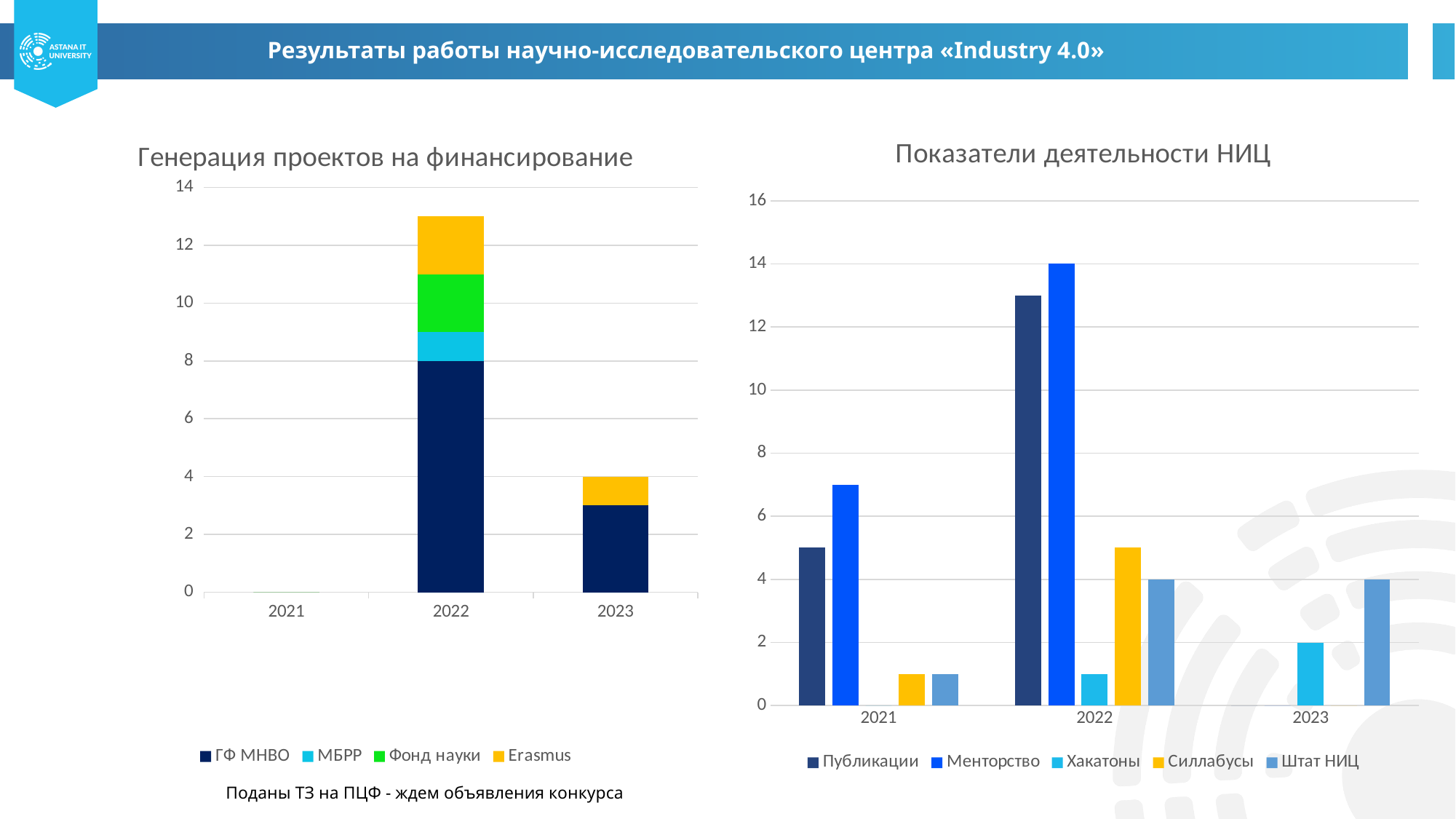
In the right chart, "Показатели деятельности НИЦ", what is the value of Хакатоны for 2023? 2 In the right chart, "Показатели деятельности НИЦ", what is the value of Менторство for 2022? 14 In the left chart, "Генерация проектов на финансирование", which year has the tallest stacked bar? 2022 In the right chart, "Показатели деятельности НИЦ", which series has the highest value in 2022? Менторство How many series does the legend of the right chart, "Показатели деятельности НИЦ", list? 5 In the right chart, "Показатели деятельности НИЦ", which is larger: Публикации in 2021 or Менторство in 2021? Менторство in 2021 In the left chart, "Генерация проектов на финансирование", is the total for 2022 greater or less than 12? greater How many series does the legend of the left chart, "Генерация проектов на финансирование", list? 4 In the right chart, "Показатели деятельности НИЦ", is the value of Публикации for 2022 greater or less than 12? greater How many year categories are shown on the x axis of the right chart, "Показатели деятельности НИЦ"? 3 What kind of chart is the left chart, "Генерация проектов на финансирование"? Stacked bar chart In the right chart, "Показатели деятельности НИЦ", what is the value of Штат НИЦ for 2023? 4